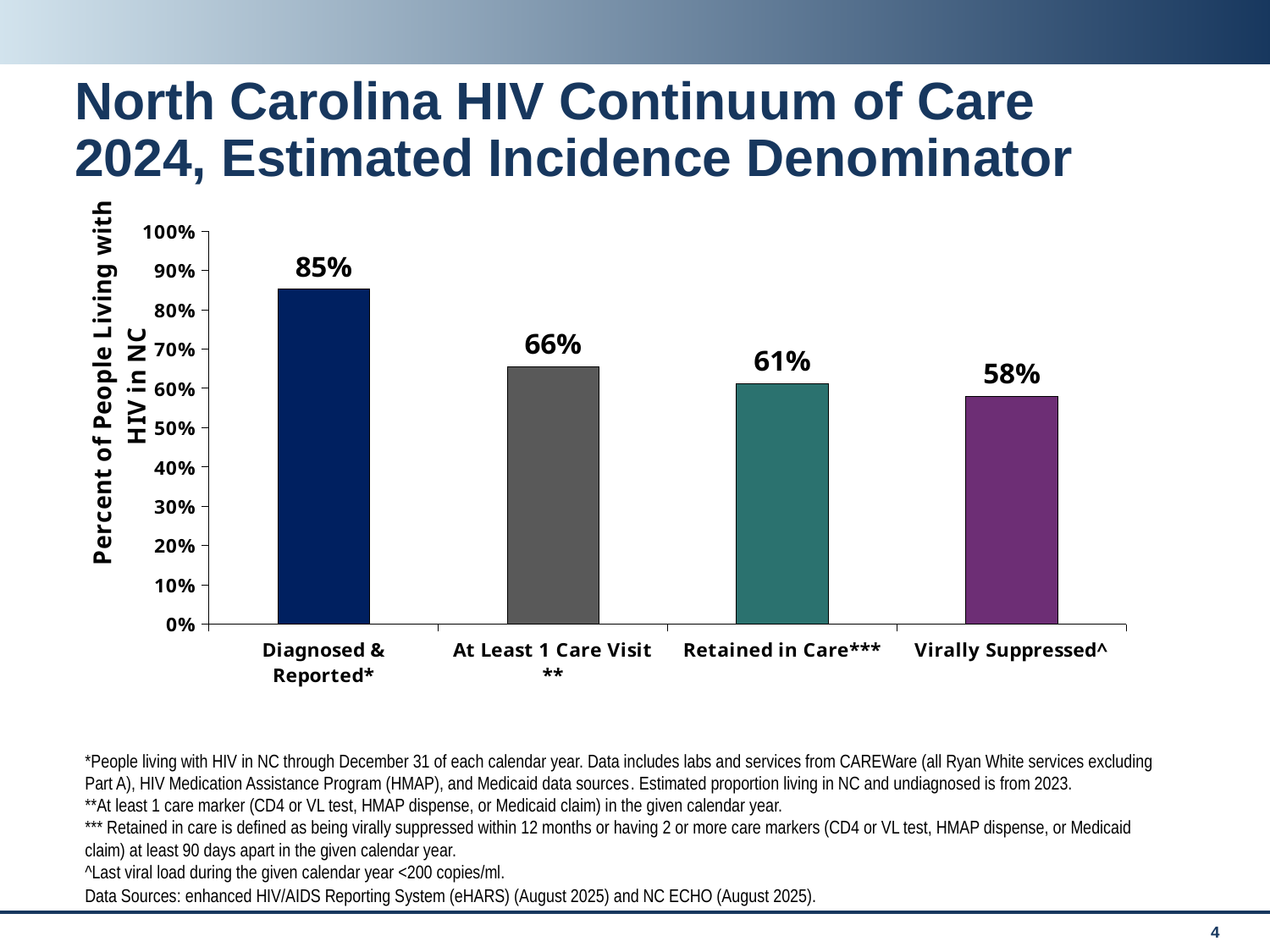
Which is larger, the value for At Least 1 Care Visit** or the value for Virally Suppressed^? At Least 1 Care Visit** What kind of chart is shown on the slide? Bar chart Which category has the lowest value? Virally Suppressed^ What is the value for At Least 1 Care Visit**? 66% What is the value for Retained in Care***? 61% Which category has the highest value? Diagnosed & Reported* What is the value for Diagnosed & Reported*? 85% What is the difference between the values for Diagnosed & Reported* and Virally Suppressed^? 27% What is the difference between the values for At Least 1 Care Visit** and Retained in Care***? 5% How many categories are shown on the chart? 4 What is the value for Virally Suppressed^? 58% Do the values rise or fall from left to right across the categories? Fall